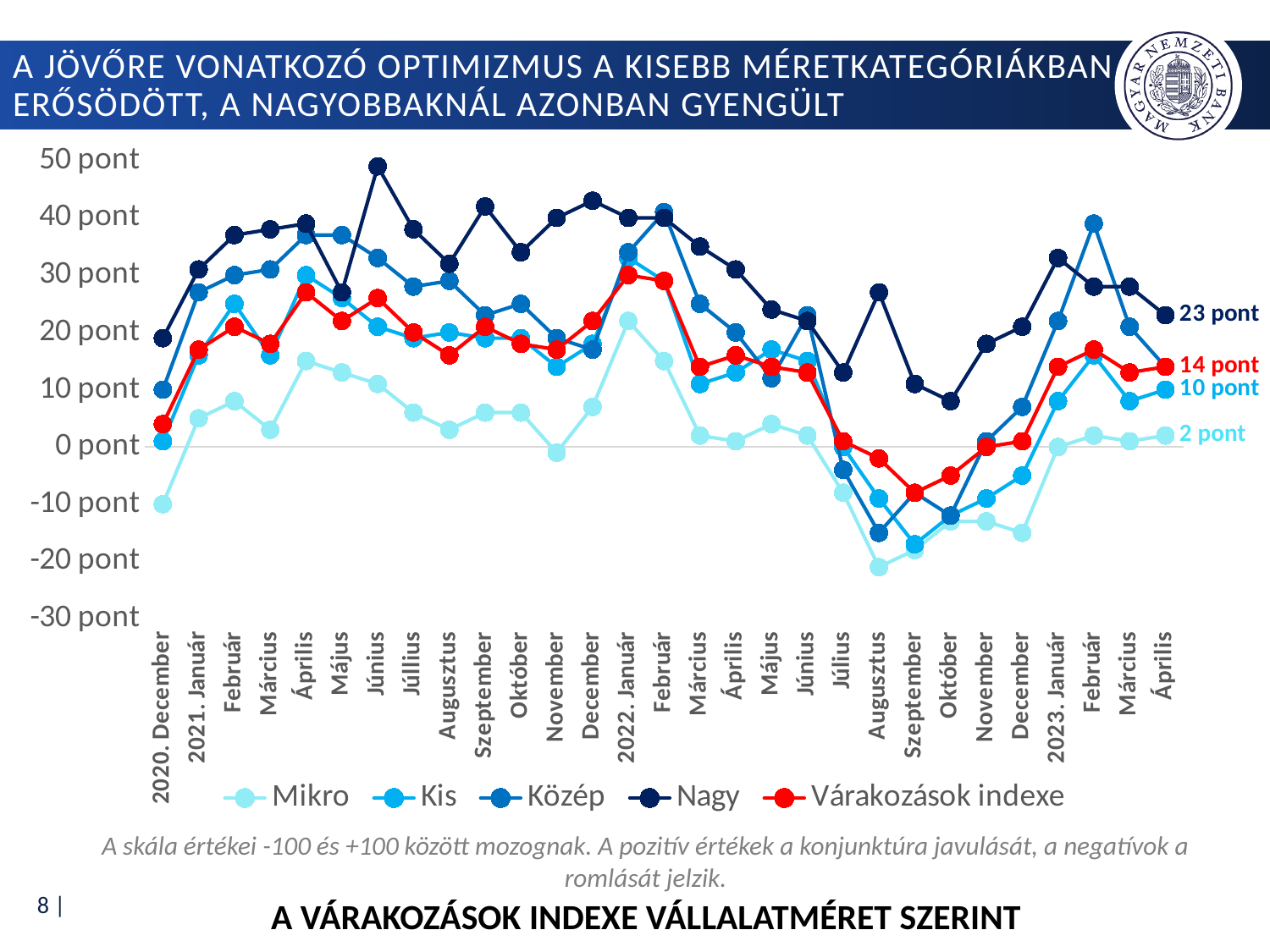
Which series has the lowest value in 2023 Április? Mikro What is the value of the Kis series in 2023 Április? 10 pont What is the title of the chart shown below the legend? A VÁRAKOZÁSOK INDEXE VÁLLALATMÉRET SZERINT Is the value of the Mikro series in 2022 Augusztus greater or less than -10 pont? less How many series does the legend list? 5 What is the value of the Várakozások indexe series in 2023 Április? 14 pont Which series has the highest value in 2023 Április? Nagy What is the value of the Mikro series in 2023 Április? 2 pont What is the difference between the Nagy and Mikro values in 2023 Április? 21 pont What is the value of the Nagy series in 2023 Április? 23 pont What kind of chart is shown on the slide? line chart Is the value of the Nagy series in 2021 Június greater or less than 40 pont? greater